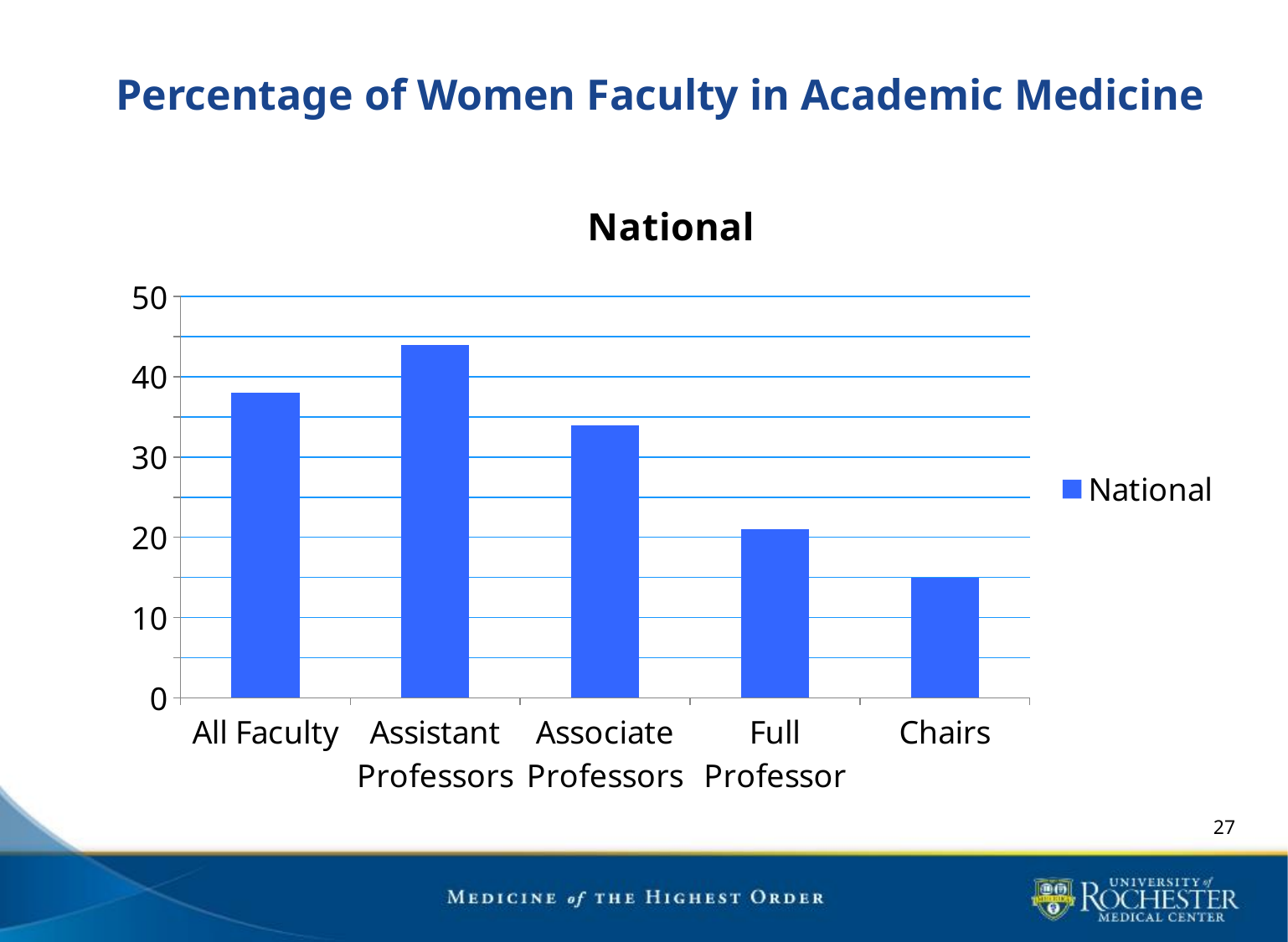
How many categories are shown on the x axis of the chart? 5 How many series does the chart's legend list? 1 Is the value for Chairs greater or less than 20? less Is the value for Associate Professors greater or less than 40? less Which is larger, the value for Full Professor or the value for Chairs? Full Professor Which category has the lowest value in the chart? Chairs Moving from Assistant Professors to Chairs along the x axis, do the values rise or fall? fall What kind of chart is shown on the slide? bar chart Which is larger, the value for All Faculty or the value for Associate Professors? All Faculty What is the title shown above the chart? National Is the value for Assistant Professors greater or less than 40? greater Which category has the highest value in the chart? Assistant Professors